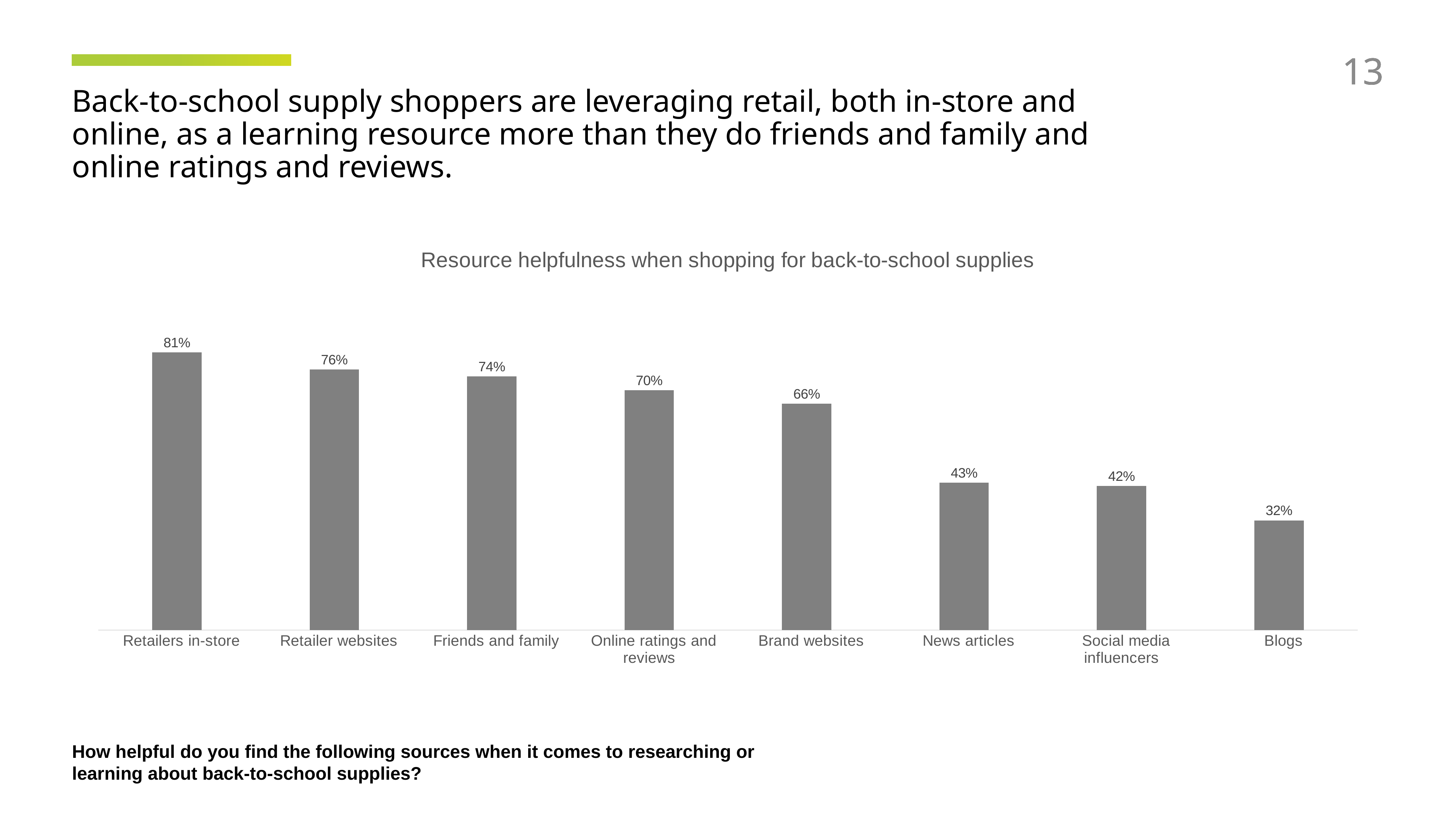
What is the value for Retailers in-store? 81% What is the difference between the values for Retailer websites and Friends and family? 2% What is the value for Social media influencers? 42% Which is larger, the value for Brand websites or the value for News articles? Brand websites How many categories are shown in the chart? 8 What is the title of the chart? Resource helpfulness when shopping for back-to-school supplies Which category has the highest value? Retailers in-store What is the value for Online ratings and reviews? 70% Which category has the lowest value? Blogs Do the values rise or fall from left to right along the x axis? Fall What kind of chart is shown on the slide? Bar chart What is the difference between the values for Retailers in-store and Blogs? 49%